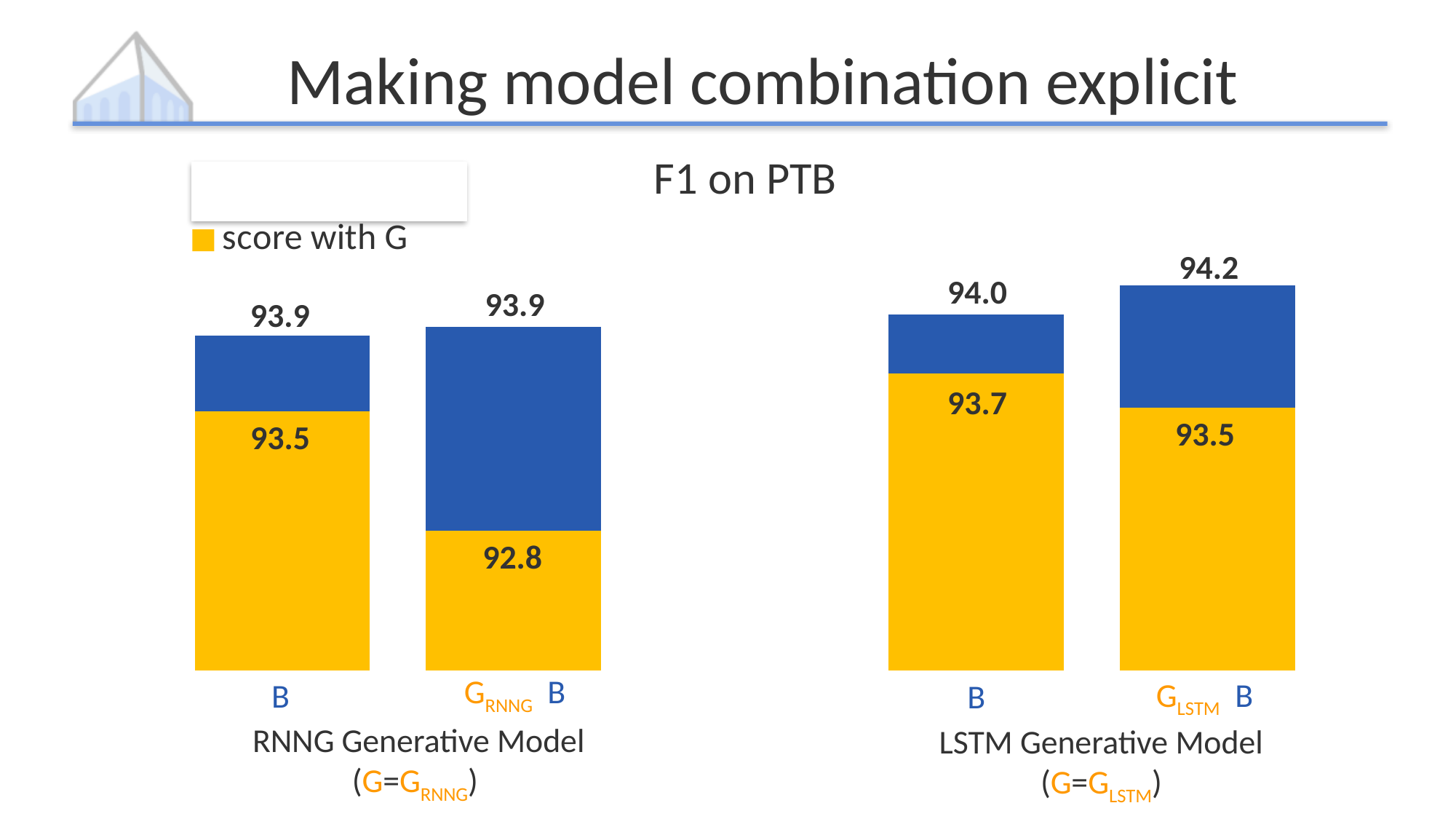
In the LSTM Generative Model chart, what value is labelled at the top of the G_LSTM B bar? 94.2 In the RNNG Generative Model chart, what is the difference between the score with G for the B bar and for the G_RNNG B bar? 0.7 What is the overall title shown above the charts? F1 on PTB In the RNNG Generative Model chart, which bar has the higher score with G, B or G_RNNG B? B In the LSTM Generative Model chart, what is the score with G for the G_LSTM B bar? 93.5 In the RNNG Generative Model chart, what value is labelled at the top of the B bar? 93.9 In the LSTM Generative Model chart, what is the score with G for the B bar? 93.7 How many bars are in the LSTM Generative Model chart? 2 In the LSTM Generative Model chart, which bar has the higher value labelled at its top? G_LSTM B In the RNNG Generative Model chart, what is the score with G for the B bar? 93.5 In the RNNG Generative Model chart, what is the score with G for the G_RNNG B bar? 92.8 In the LSTM Generative Model chart, what is the difference between the top values of the G_LSTM B bar and the B bar? 0.2